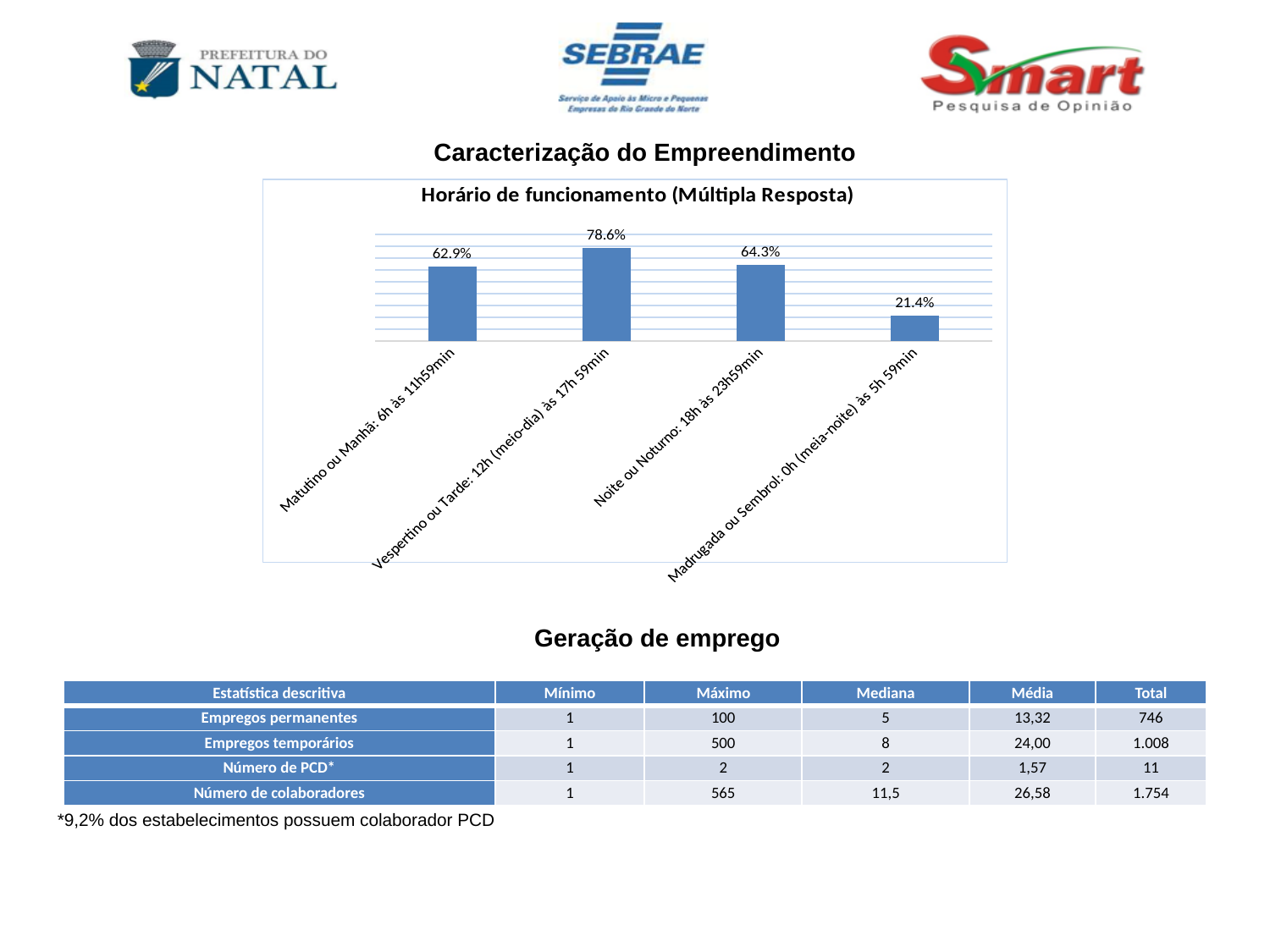
How many categories are shown in the chart? 4 What is the value for "Vespertino ou Tarde: 12h (meio-dia) às 17h 59min" in the chart? 78.6% What is the difference between the values for "Vespertino ou Tarde" and "Madrugada ou Sembrol" in the chart? 57.2% What is the value for "Noite ou Noturno: 18h às 23h59min" in the chart? 64.3% What is the difference between the values for "Vespertino ou Tarde" and "Matutino ou Manhã" in the chart? 15.7% What is the value for "Madrugada ou Sembrol: 0h (meia-noite) às 5h 59min" in the chart? 21.4% What is the value for "Matutino ou Manhã: 6h às 11h59min" in the chart? 62.9% Which operating period has the lowest value in the chart? Madrugada ou Sembrol: 0h (meia-noite) às 5h 59min Which has a larger value in the chart, "Noite ou Noturno" or "Matutino ou Manhã"? Noite ou Noturno What is the title of the chart on the slide? Horário de funcionamento (Múltipla Resposta) What type of chart is shown under the title "Horário de funcionamento (Múltipla Resposta)"? bar chart Which operating period has the highest value in the chart? Vespertino ou Tarde: 12h (meio-dia) às 17h 59min